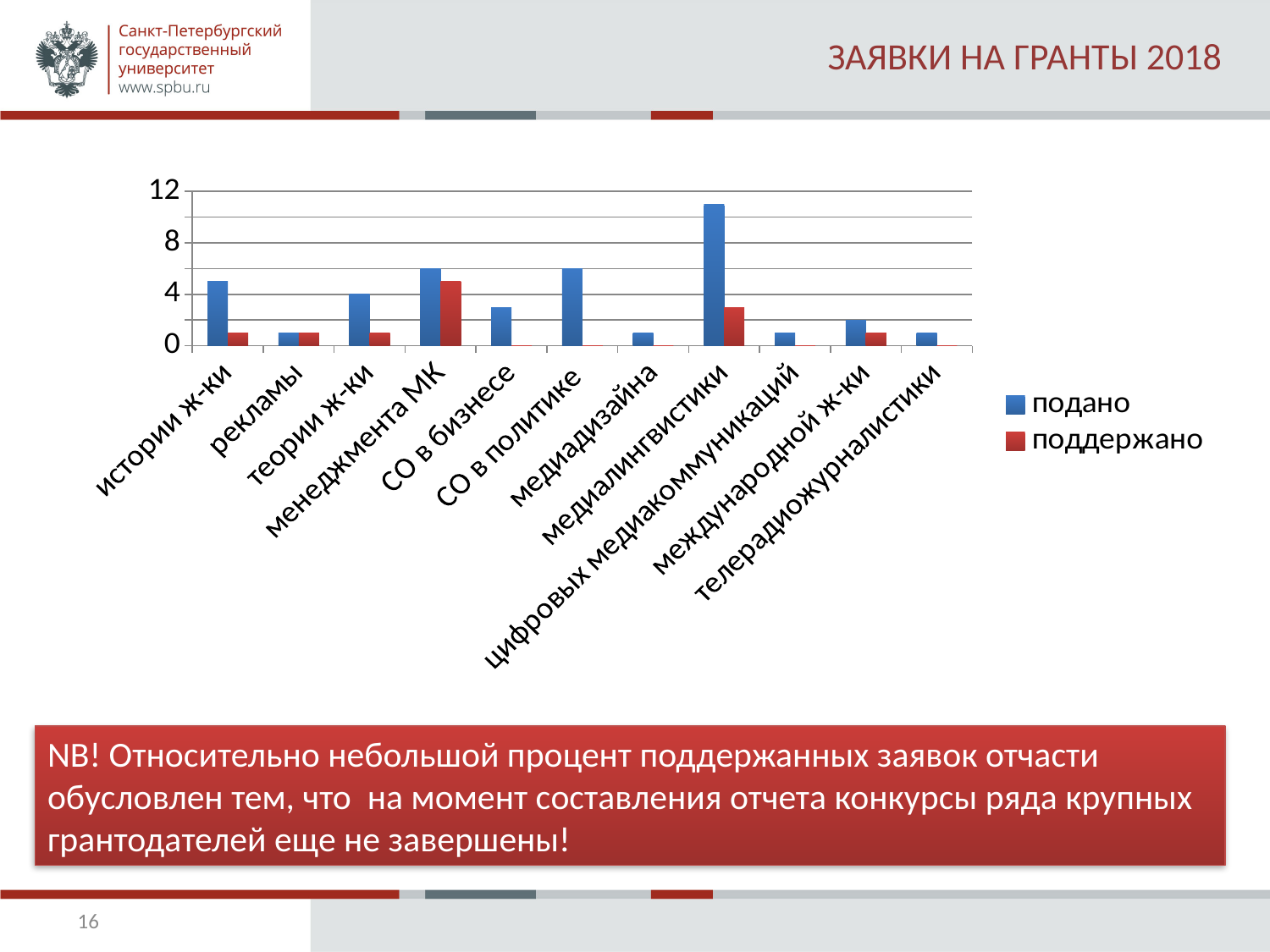
What are the two series named in the legend? подано, поддержано Is the value of 'подано' for СО в бизнесе greater or less than 4? less Which is larger: the 'подано' value for медиалингвистики or for истории ж-ки? медиалингвистики Is the value of 'подано' for медиалингвистики greater or less than 8? greater Which category has the highest value for the series 'подано'? медиалингвистики Is the value of 'подано' for истории ж-ки greater or less than 4? greater How many series does the legend list? 2 What is the title of the slide containing the chart? ЗАЯВКИ НА ГРАНТЫ 2018 What kind of chart is shown on the slide? bar chart How many categories are shown on the x axis of the chart? 11 Which category has the highest value for the series 'поддержано'? менеджмента МК